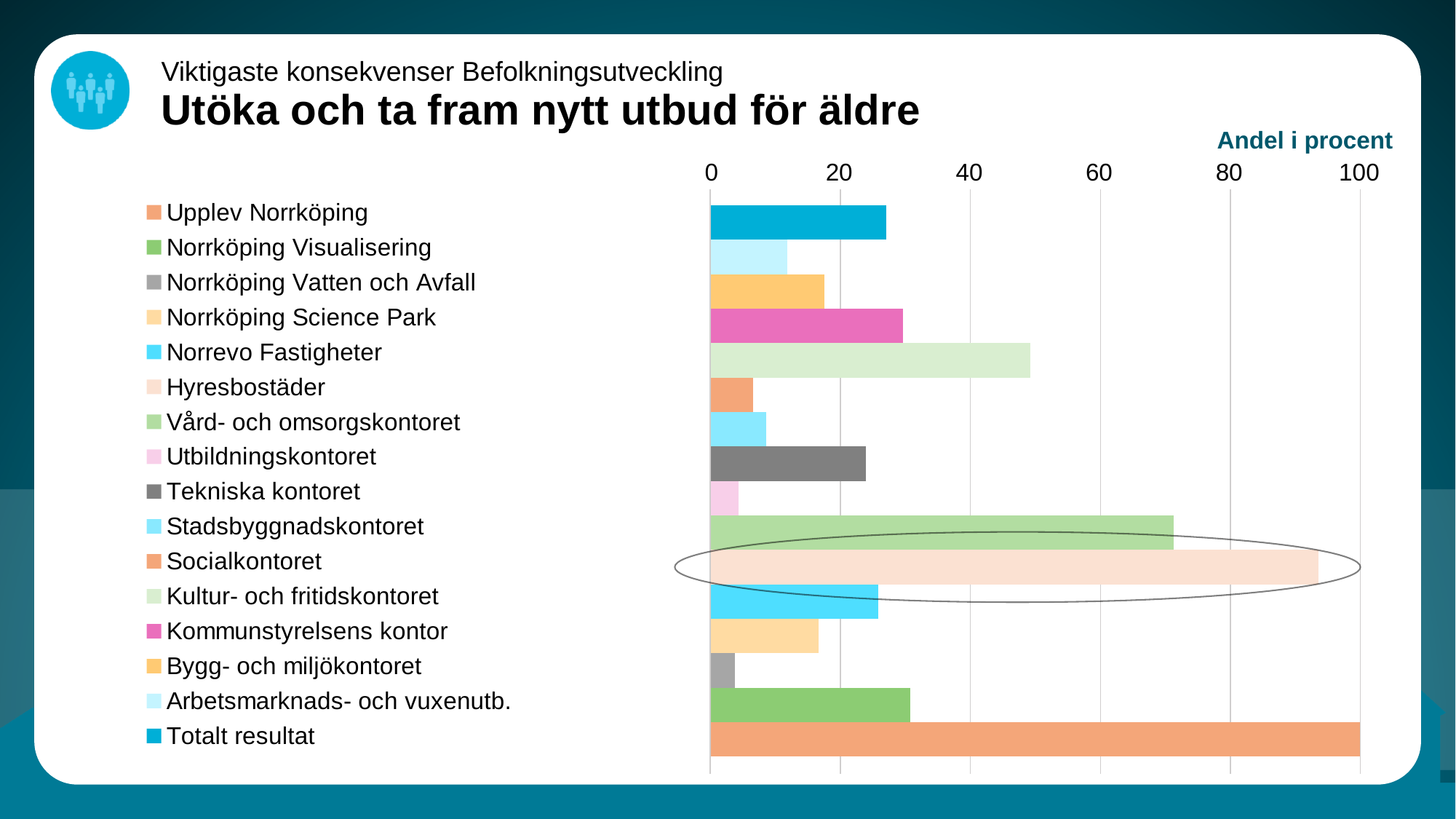
What kind of chart is shown on the slide? bar chart Is the value for Kultur- och fritidskontoret greater or less than 40? greater How many categories does the legend list? 16 Which category has the highest value? Upplev Norrköping Which is larger, the value for Kultur- och fritidskontoret or the value for Kommunstyrelsens kontor? Kultur- och fritidskontoret What label is shown above the horizontal axis of the chart? Andel i procent Is the value for Hyresbostäder greater or less than 80? greater What is the value for Upplev Norrköping? 100 Is the value for Socialkontoret greater or less than 20? less Which is larger, the value for Hyresbostäder or the value for Vård- och omsorgskontoret? Hyresbostäder